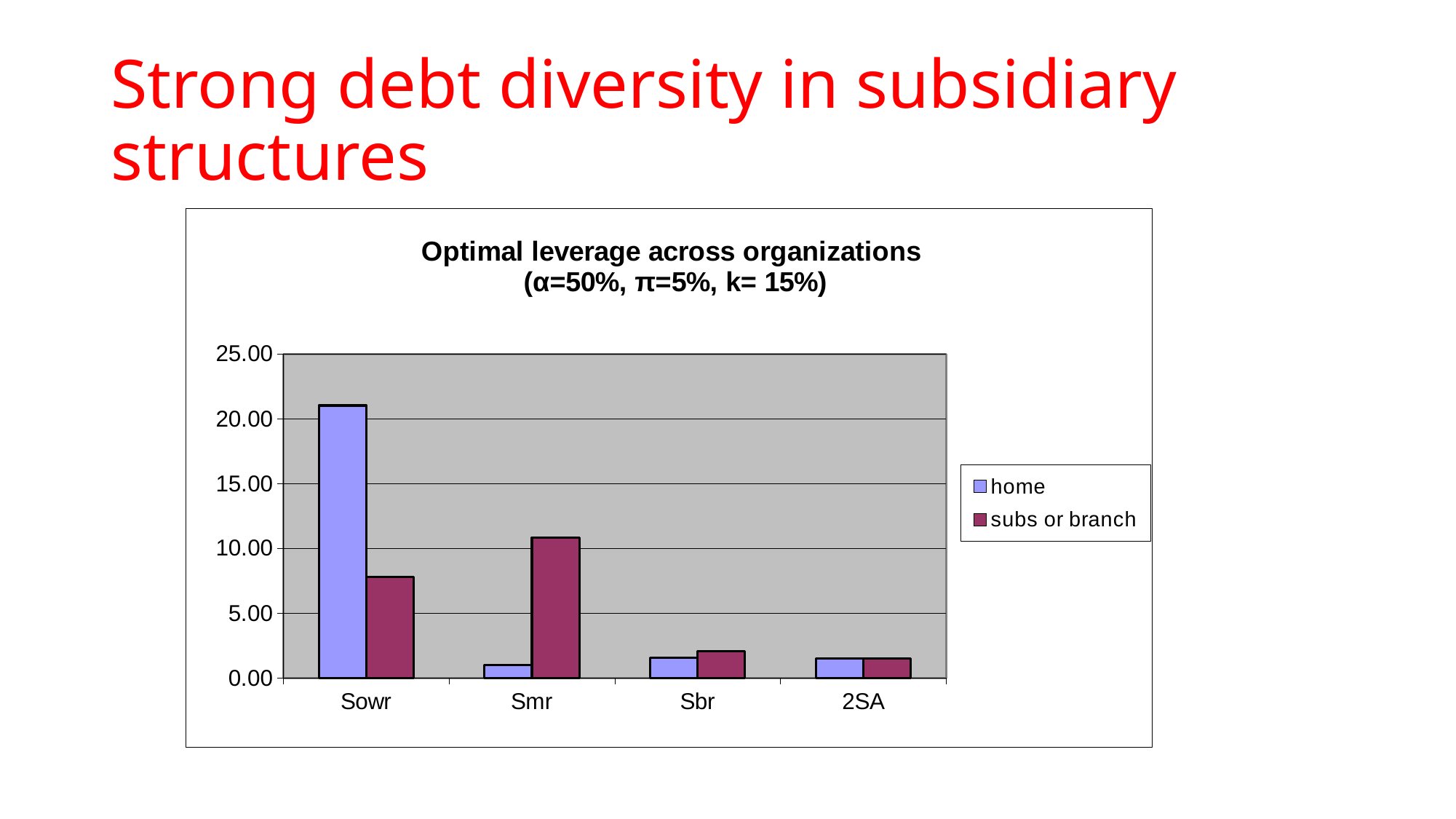
Is the subs or branch value for Sowr greater or less than 10.00? less For Sowr, which is larger: the home value or the subs or branch value? home Which category has the highest value for the subs or branch series? Smr Is the subs or branch value for Smr greater or less than 10.00? greater What are the two series named in the legend? home; subs or branch What is the title of the chart? Optimal leverage across organizations (α=50%, π=5%, k= 15%) How many categories are shown on the x axis of the chart? 4 What kind of chart is shown on the slide? bar chart For Smr, which is larger: the home value or the subs or branch value? subs or branch Which category has the highest value for the home series? Sowr How many series does the legend list? 2 Is the home value for Sowr greater or less than 20.00? greater